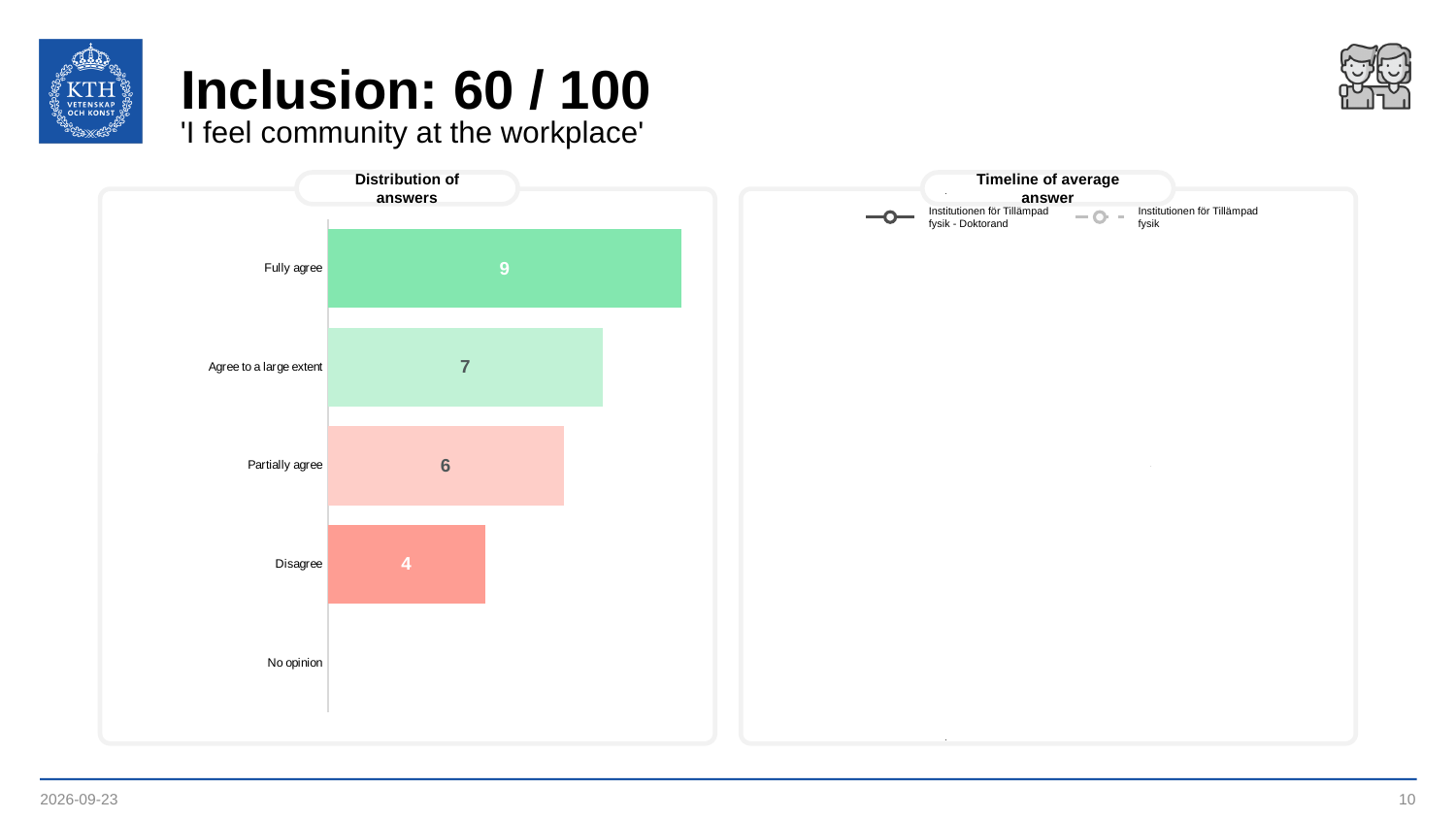
In the 'Distribution of answers' chart, what is the value for 'Disagree'? 4 In the 'Distribution of answers' chart, what is the difference between 'Fully agree' and 'Agree to a large extent'? 2 In the 'Distribution of answers' chart, which of the categories with a labelled bar has the lowest value? Disagree In the 'Distribution of answers' chart, what is the difference between 'Fully agree' and 'Disagree'? 5 In the 'Distribution of answers' chart, what is the value for 'Partially agree'? 6 In the 'Distribution of answers' chart, which is larger: 'Partially agree' or 'Disagree'? Partially agree In the 'Distribution of answers' chart, which answer category has the highest value? Fully agree What kind of chart is the 'Distribution of answers' chart? Bar chart In the 'Distribution of answers' chart, what is the value for 'Agree to a large extent'? 7 In the 'Distribution of answers' chart, how many respondents chose 'Fully agree'? 9 How many answer categories are listed on the y axis of the 'Distribution of answers' chart? 5 How many series does the legend of the 'Timeline of average answer' chart list? 2